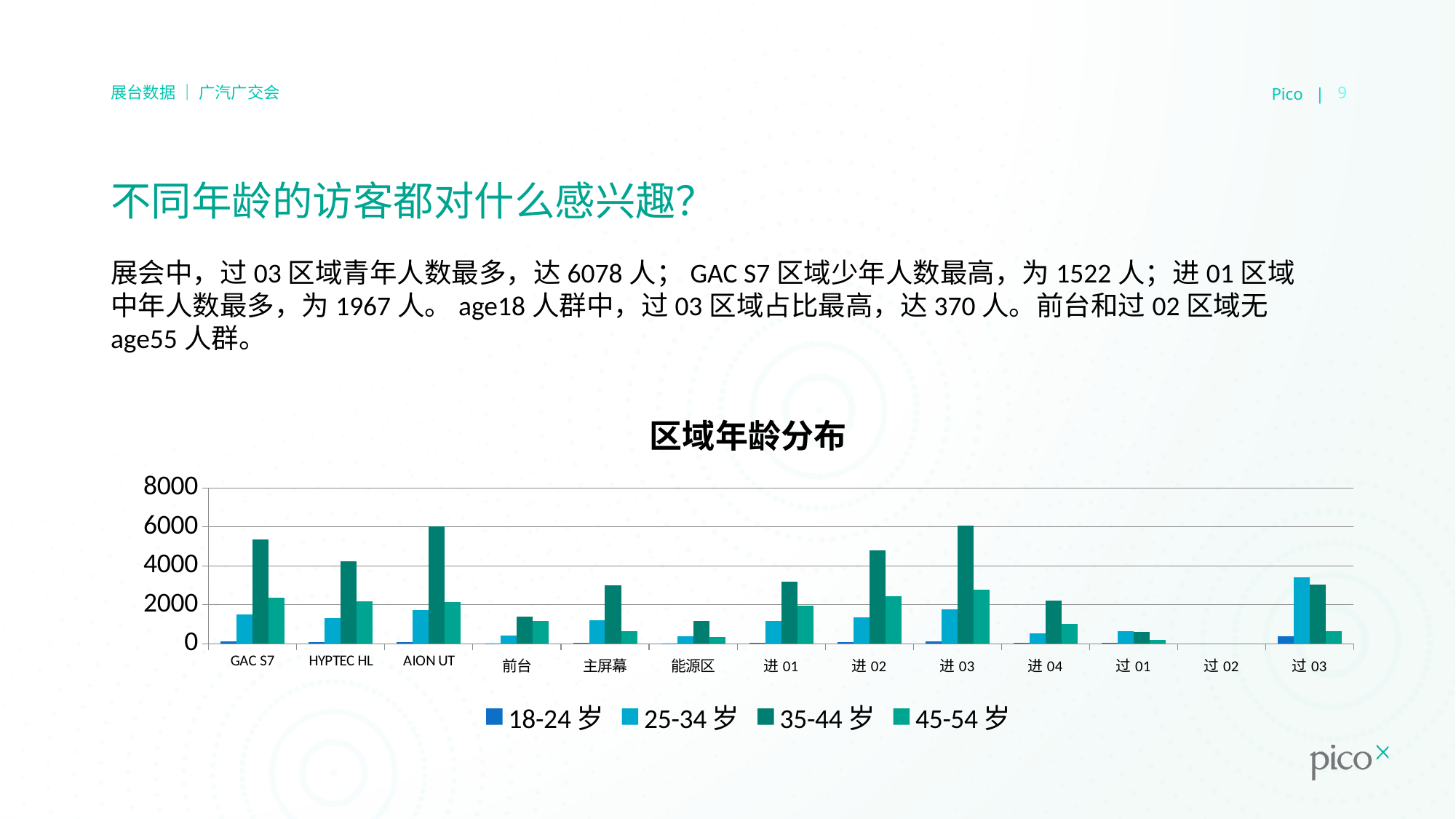
Is the 25-34 岁 value for 过 03 greater or less than 2000? greater Which is larger, the 35-44 岁 value for 主屏幕 or the 35-44 岁 value for 能源区? 主屏幕 Is the 35-44 岁 value for GAC S7 greater or less than 4000? greater Is the 35-44 岁 value for 进 02 greater or less than 4000? greater What is the title of the chart? 区域年龄分布 What kind of chart is shown on the slide? bar chart How many categories are shown along the x axis of the chart? 13 Which is larger, the 35-44 岁 value for GAC S7 or the 35-44 岁 value for HYPTEC HL? GAC S7 How many series does the chart's legend list? 4 Which category has the lowest values across all age groups? 过 02 Which age groups are listed in the chart's legend? 18-24 岁, 25-34 岁, 35-44 岁, 45-54 岁